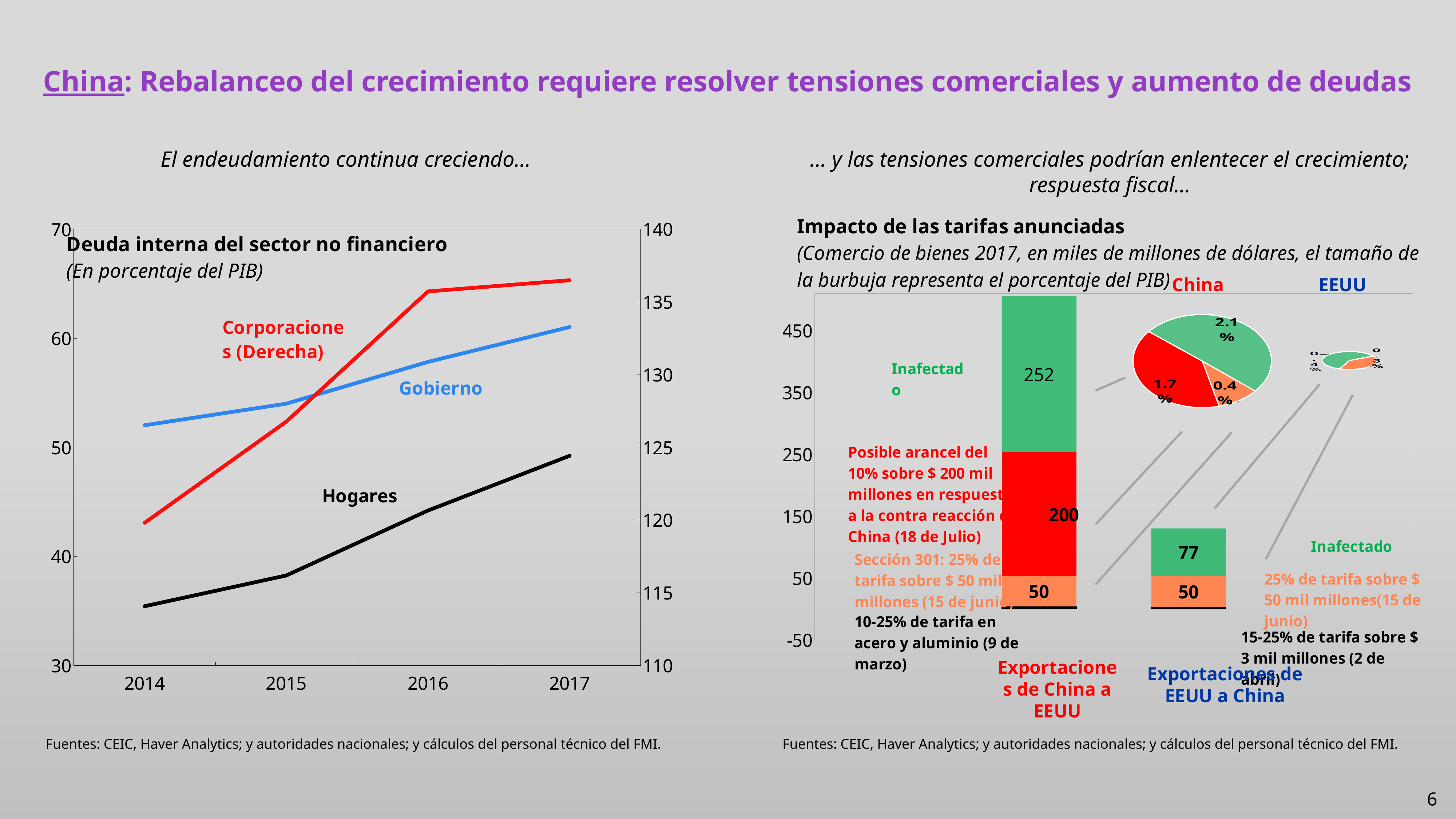
In the left chart 'Deuda interna del sector no financiero', how many years are shown on the x axis? 4 In the left chart 'Deuda interna del sector no financiero', which series is plotted on the right-hand axis? Corporaciones In the right chart 'Impacto de las tarifas anunciadas', what is the difference between the green segments of the two bars (252 and 77)? 175 In the left chart 'Deuda interna del sector no financiero', is the value for Hogares in 2014 greater or less than 40? less What kind of chart is the left chart, 'Deuda interna del sector no financiero'? line chart In the right chart 'Impacto de las tarifas anunciadas', what is the value of the green 'Inafectado' segment in the 'Exportaciones de EEUU a China' bar? 77 In the right chart 'Impacto de las tarifas anunciadas', what is the value of the red segment in the 'Exportaciones de China a EEUU' bar? 200 In the left chart 'Deuda interna del sector no financiero', is the value for Gobierno in 2017 greater or less than 60? greater In the right chart 'Impacto de las tarifas anunciadas', which bar is taller: 'Exportaciones de China a EEUU' or 'Exportaciones de EEUU a China'? Exportaciones de China a EEUU In the left chart 'Deuda interna del sector no financiero', does the Hogares line rise or fall from 2014 to 2017? rise In the left chart 'Deuda interna del sector no financiero', is the value for Corporaciones in 2017 (right axis) greater or less than 135? greater